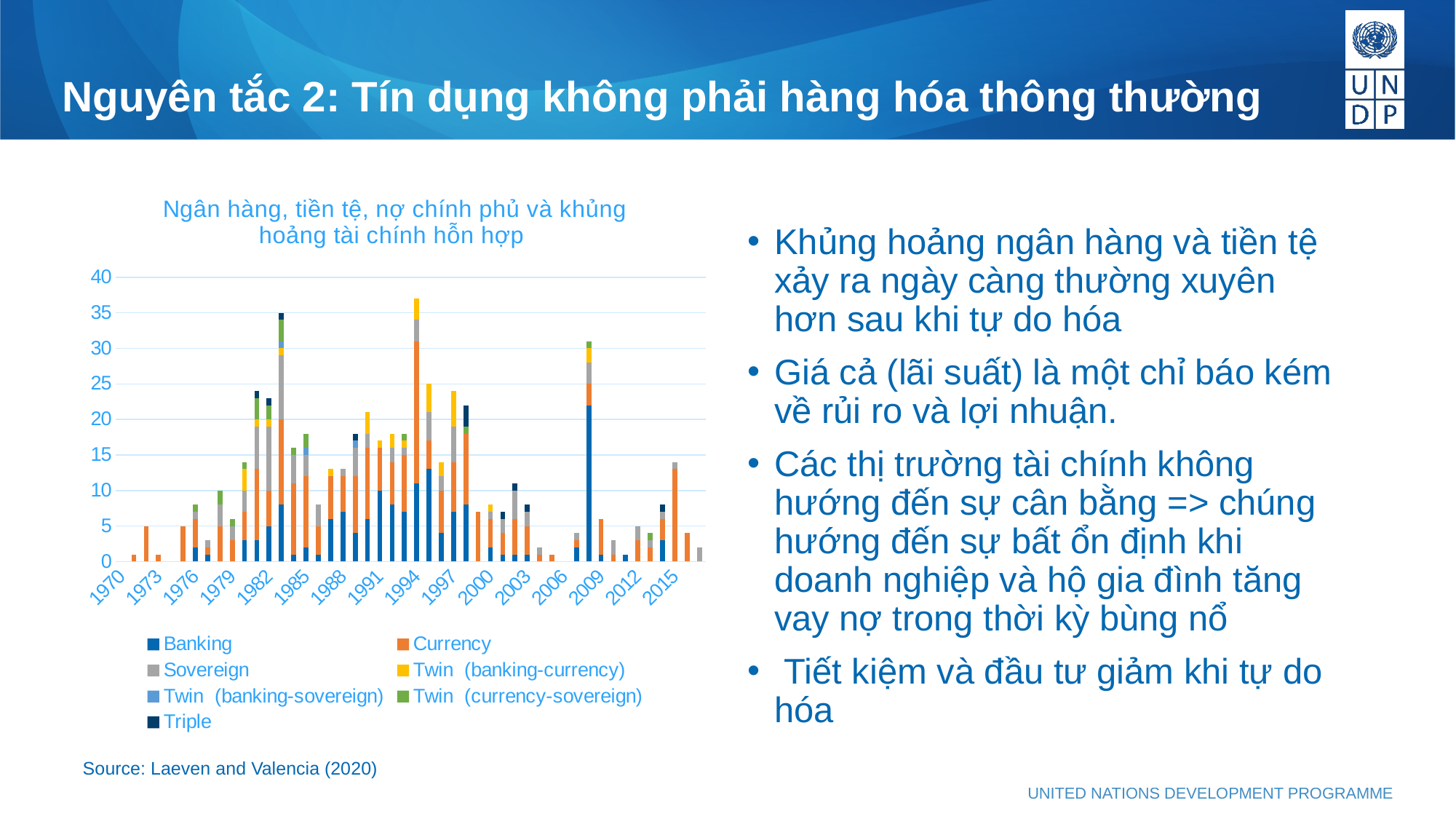
Is the total value of the bar for 2000 greater or less than 10? less What is the title of the chart? Ngân hàng, tiền tệ, nợ chính phủ và khủng hoảng tài chính hỗn hợp What source is cited below the chart? Laeven and Valencia (2020) Is the total value of the bar for 1985 greater or less than 15? greater What kind of chart is shown on the slide? Stacked bar chart Which bar is taller, the one for 1994 or the one for 1985? 1994 Is the total value of the bar for 1994 greater or less than 35? greater How many series does the chart's legend list? 7 Which bar is taller, the one for 1997 or the one for 2000? 1997 Which labeled year on the x axis has the tallest stacked bar? 1994